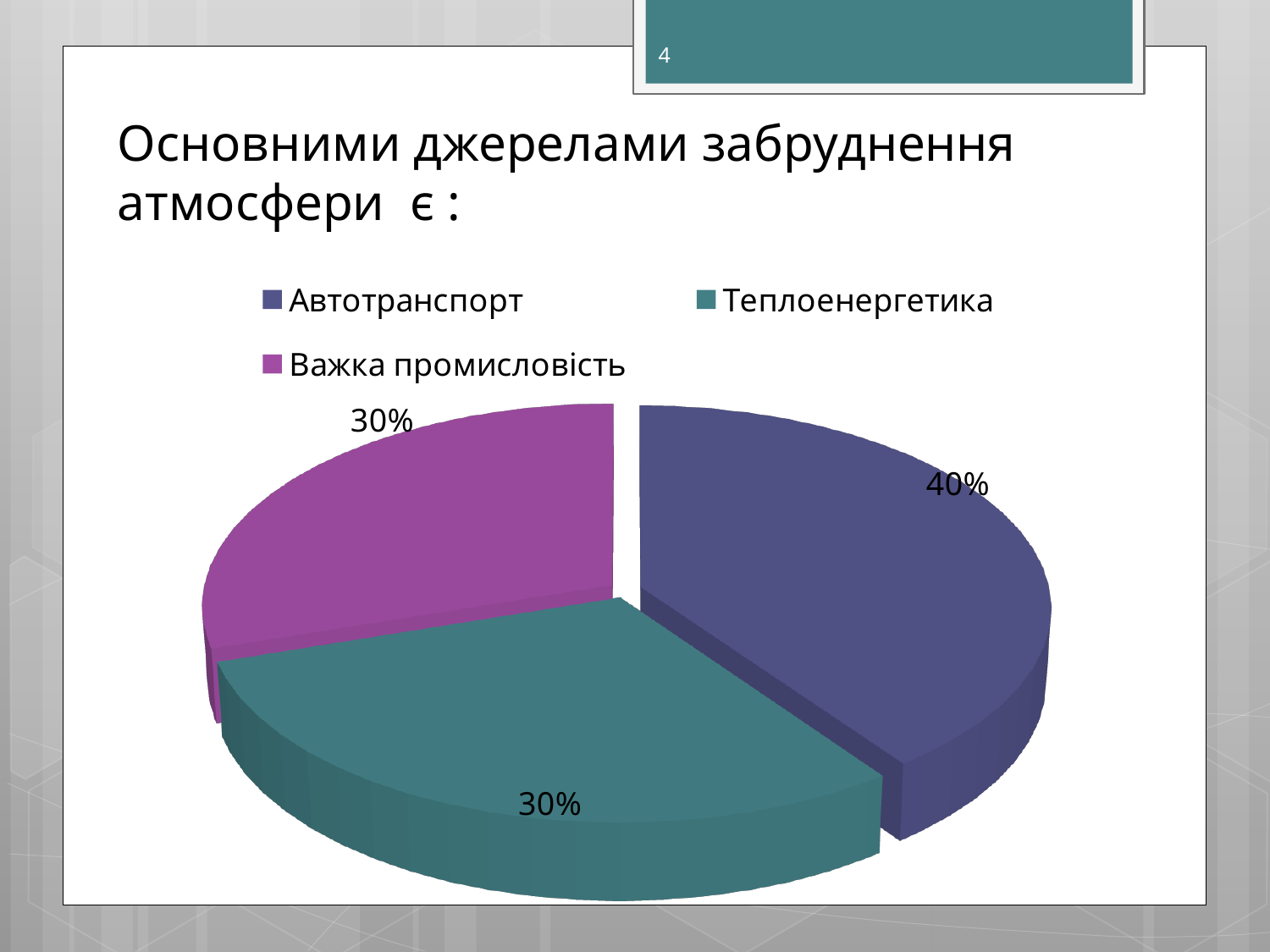
What is the difference in percentage points between Автотранспорт and Теплоенергетика? 10 percentage points What percentage does the Автотранспорт slice show? 40% What percentage does the Теплоенергетика slice show? 30% How many slices does the pie chart have? 3 What share of the pie does Автотранспорт account for? 40% What colour is the Теплоенергетика slice? Teal How many entries does the legend list? 3 What percentage does the Важка промисловість slice show? 30% What kind of chart is shown on the slide? Pie chart Which is larger, the share for Автотранспорт or the share for Важка промисловість? Автотранспорт Which source has the largest share of the pie? Автотранспорт What is the title of the slide above the chart? Основними джерелами забруднення атмосфери є :